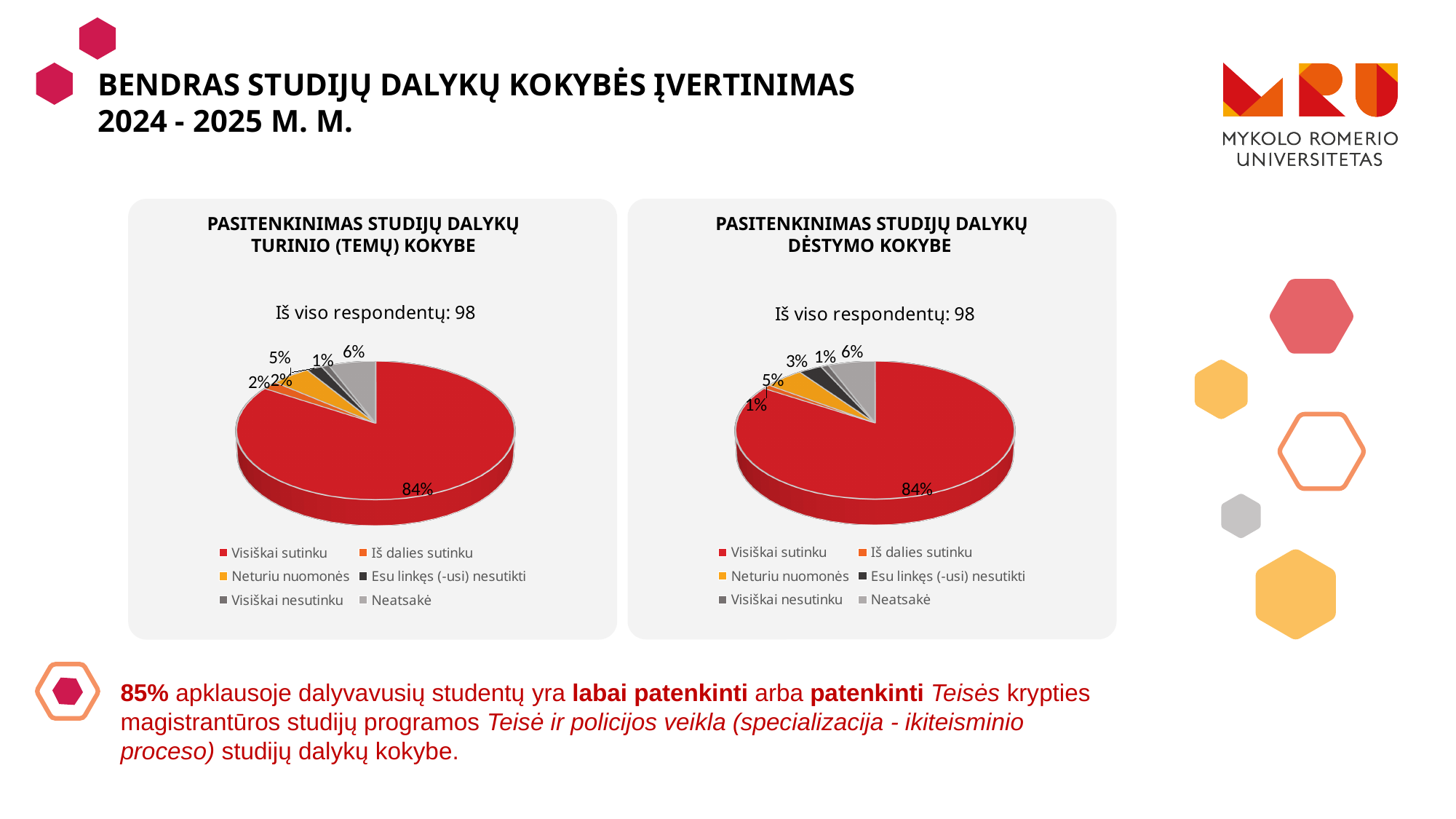
In the left chart (turinio kokybe), which is larger: 'Visiškai sutinku' or 'Neatsakė'? Visiškai sutinku In the right chart (dėstymo kokybe), what percentage is shown for 'Visiškai sutinku'? 84% In the left chart (turinio kokybe), which category has the largest share? Visiškai sutinku How many categories does the legend of the right chart (dėstymo kokybe) list? 6 In the right chart (dėstymo kokybe), which category has the largest share? Visiškai sutinku In the right chart (dėstymo kokybe), what percentage is shown for 'Neatsakė'? 6% How many respondents in total are reported above the left chart (turinio kokybe)? 98 In the right chart (dėstymo kokybe), what is the difference between the 'Visiškai sutinku' share and the 'Neatsakė' share? 78% In the left chart (turinio kokybe), what percentage is shown for 'Neatsakė'? 6% In the right chart (dėstymo kokybe), what percentage is shown for 'Neturiu nuomonės'? 5% In the left chart (turinio kokybe), what percentage is shown for 'Visiškai sutinku'? 84% What kind of chart is used in the left panel, 'Pasitenkinimas studijų dalykų turinio (temų) kokybe'? Pie chart